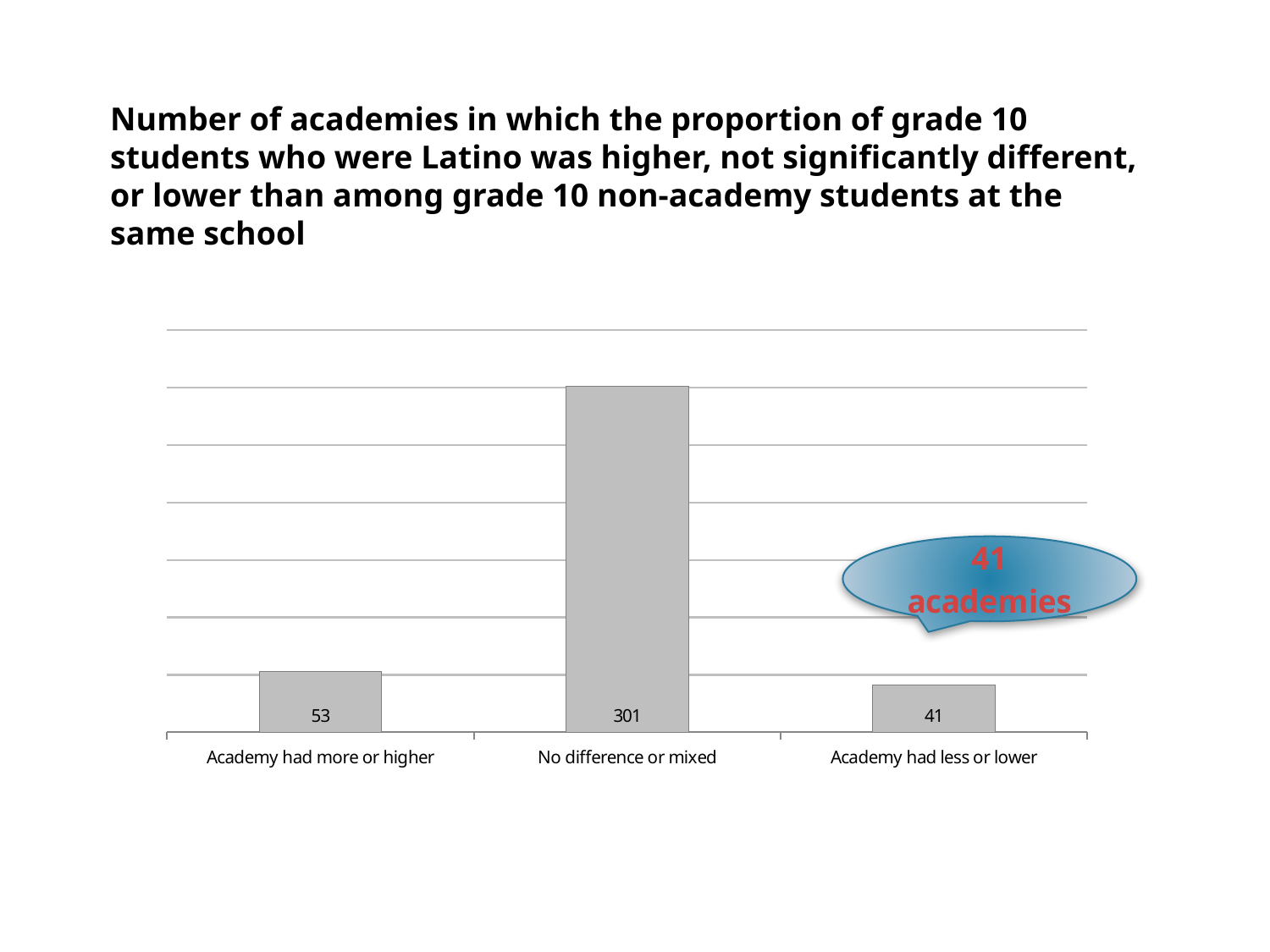
What is the value for 'Academy had more or higher'? 53 What kind of chart is shown on the slide? Bar chart What is the value for 'Academy had less or lower'? 41 What is the total of the three values shown in the chart? 395 What is the difference between the values for 'Academy had more or higher' and 'Academy had less or lower'? 12 Which is larger, the value for 'Academy had more or higher' or the value for 'Academy had less or lower'? Academy had more or higher Which category has the highest value? No difference or mixed What is the difference between the values for 'No difference or mixed' and 'Academy had more or higher'? 248 How many categories are shown on the x axis? 3 What is the value for 'No difference or mixed'? 301 Which category has the lowest value? Academy had less or lower What does the blue callout on the chart say? 41 academies